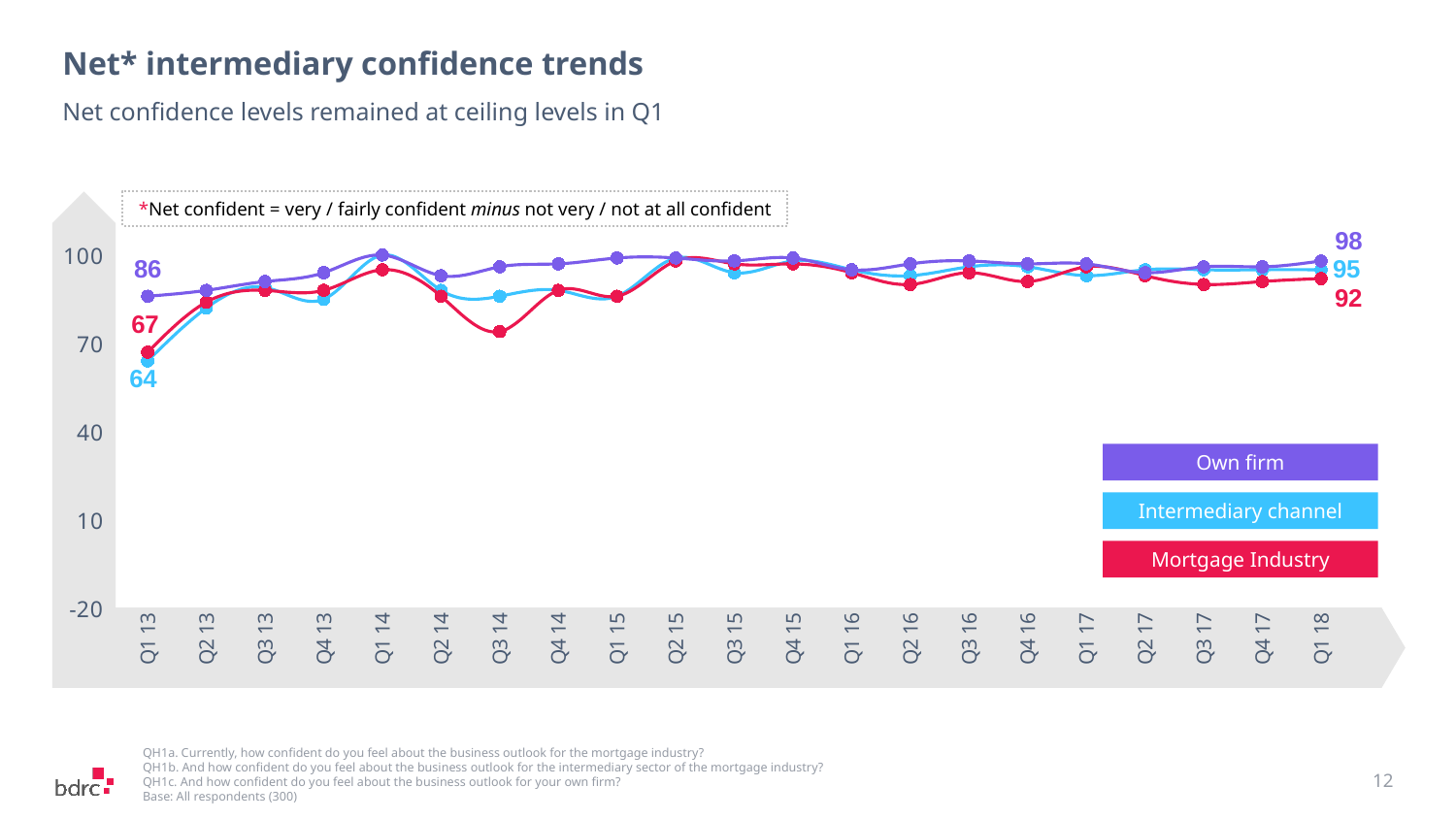
How many quarters are plotted along the x axis? 21 What is the value for Intermediary channel at Q1 18? 95 What is the value for Own firm at Q1 18? 98 What is the value for Mortgage Industry at Q1 18? 92 At Q1 13, which is higher: Own firm or Intermediary channel? Own firm What is the difference between the Own firm and Mortgage Industry values at Q1 13? 19 What is the value for Own firm at Q1 13? 86 What kind of chart is shown on the slide? line chart What is the value for Mortgage Industry at Q1 13? 67 What is the value for Intermediary channel at Q1 13? 64 By how much did the Own firm value increase from Q1 13 to Q1 18? 12 How many series does the legend list? 3